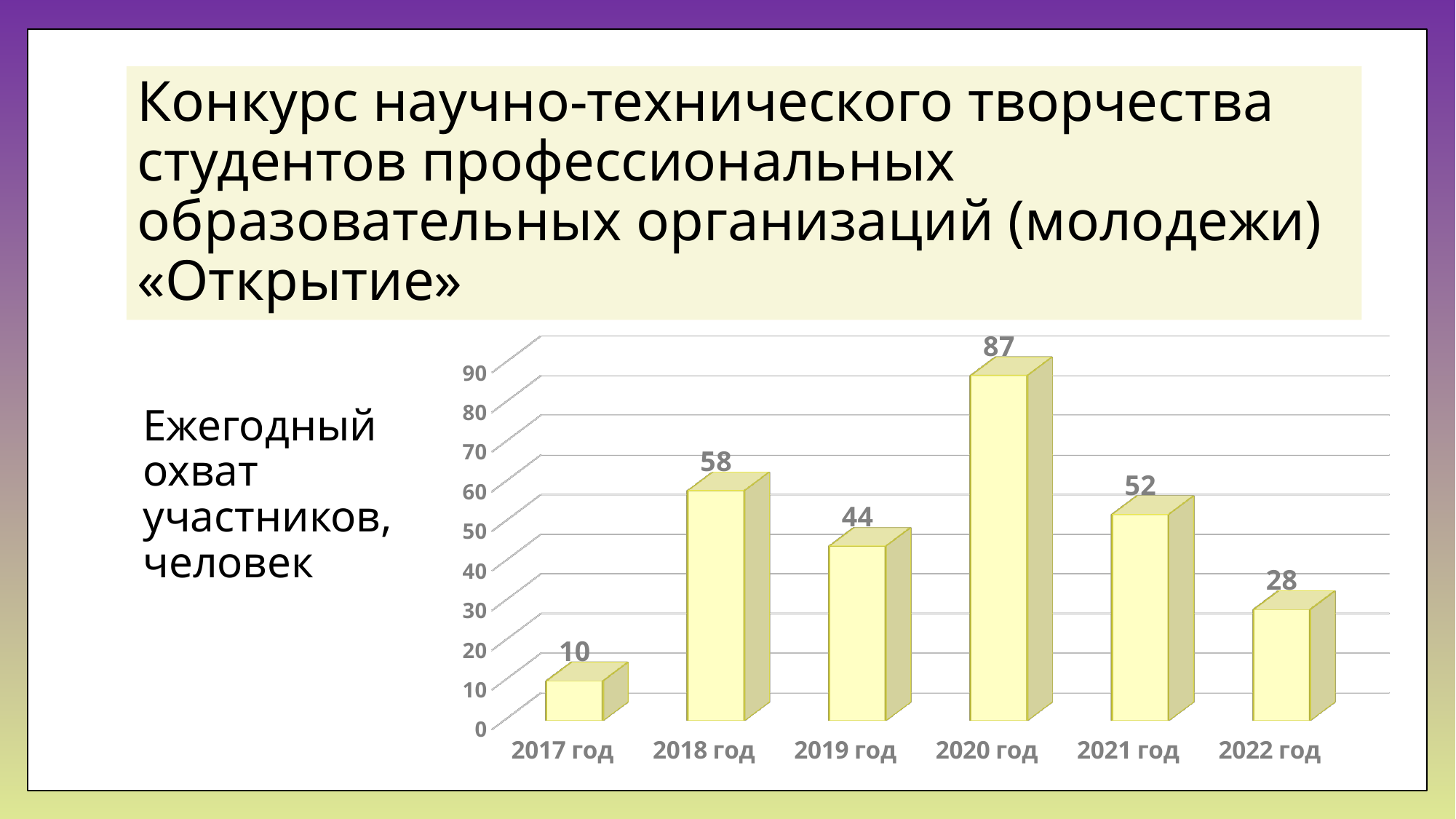
Do the values rise or fall from 2020 год to 2022 год? fall What is the value for 2020 год? 87 Which year has the lowest value? 2017 год What is the difference between the values for 2020 год and 2021 год? 35 What kind of chart is shown on the slide? bar chart What is the value for 2022 год? 28 Which is larger, the value for 2018 год or the value for 2021 год? 2018 год Is the value for 2019 год greater or less than 50? less What is the difference between the values for 2018 год and 2019 год? 14 How many years are shown on the x axis? 6 Which year has the highest value? 2020 год What is the value for 2017 год? 10